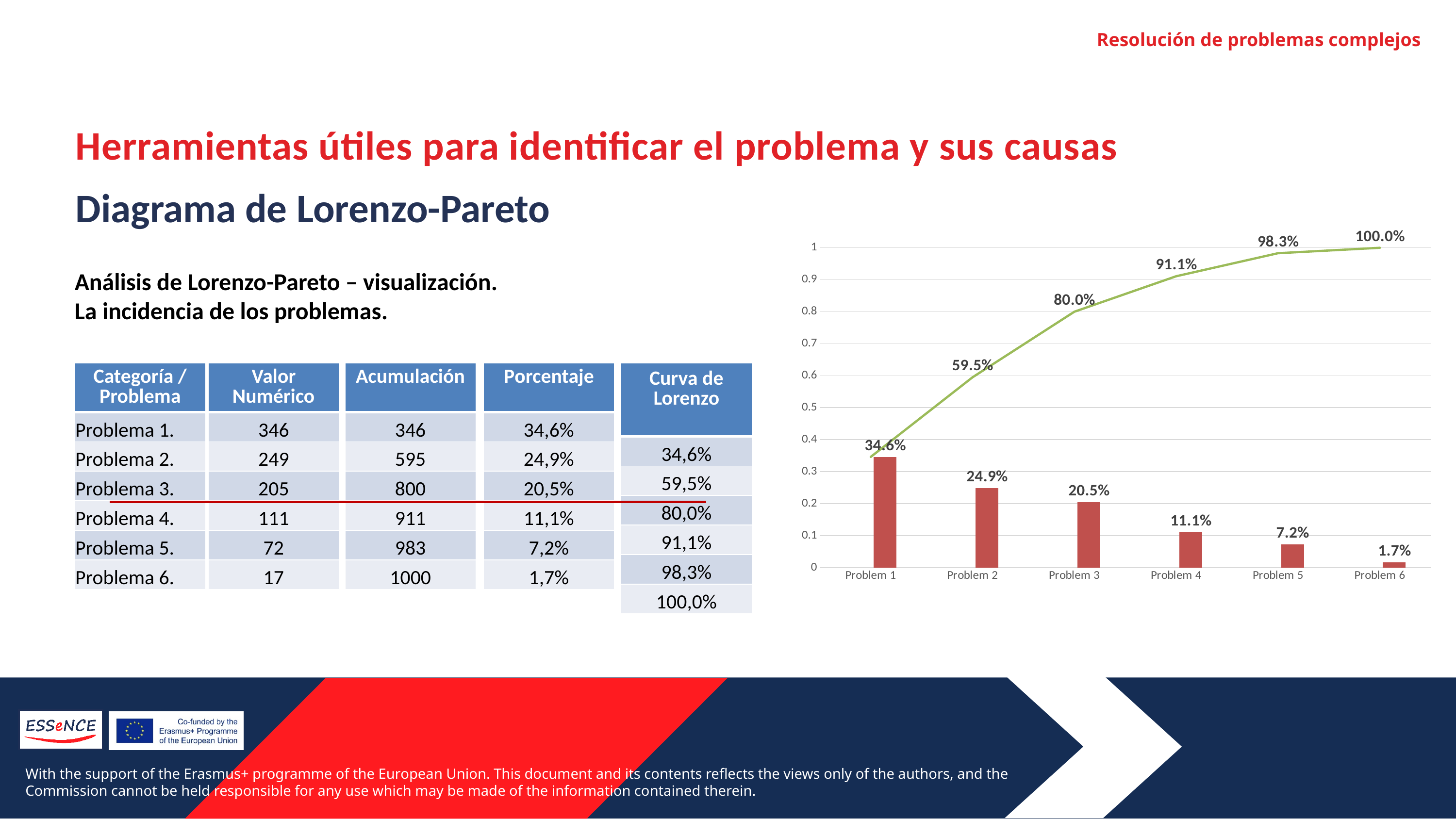
What is the cumulative line value at Problem 5? 98.3% Which problem has the highest bar? Problem 1 What is the bar value for Problem 4? 11.1% What is the bar value for Problem 1? 34.6% What is the difference between the bar values for Problem 2 and Problem 3? 4.4% What is the cumulative line value at Problem 3? 80.0% Which has a larger bar value, Problem 4 or Problem 5? Problem 4 How many problem categories are shown on the x axis? 6 Does the cumulative line rise or fall from Problem 1 to Problem 6? rise What colour is the cumulative line in the chart? green Do the bar values rise or fall from Problem 1 to Problem 6? fall Which problem has the lowest bar? Problem 6